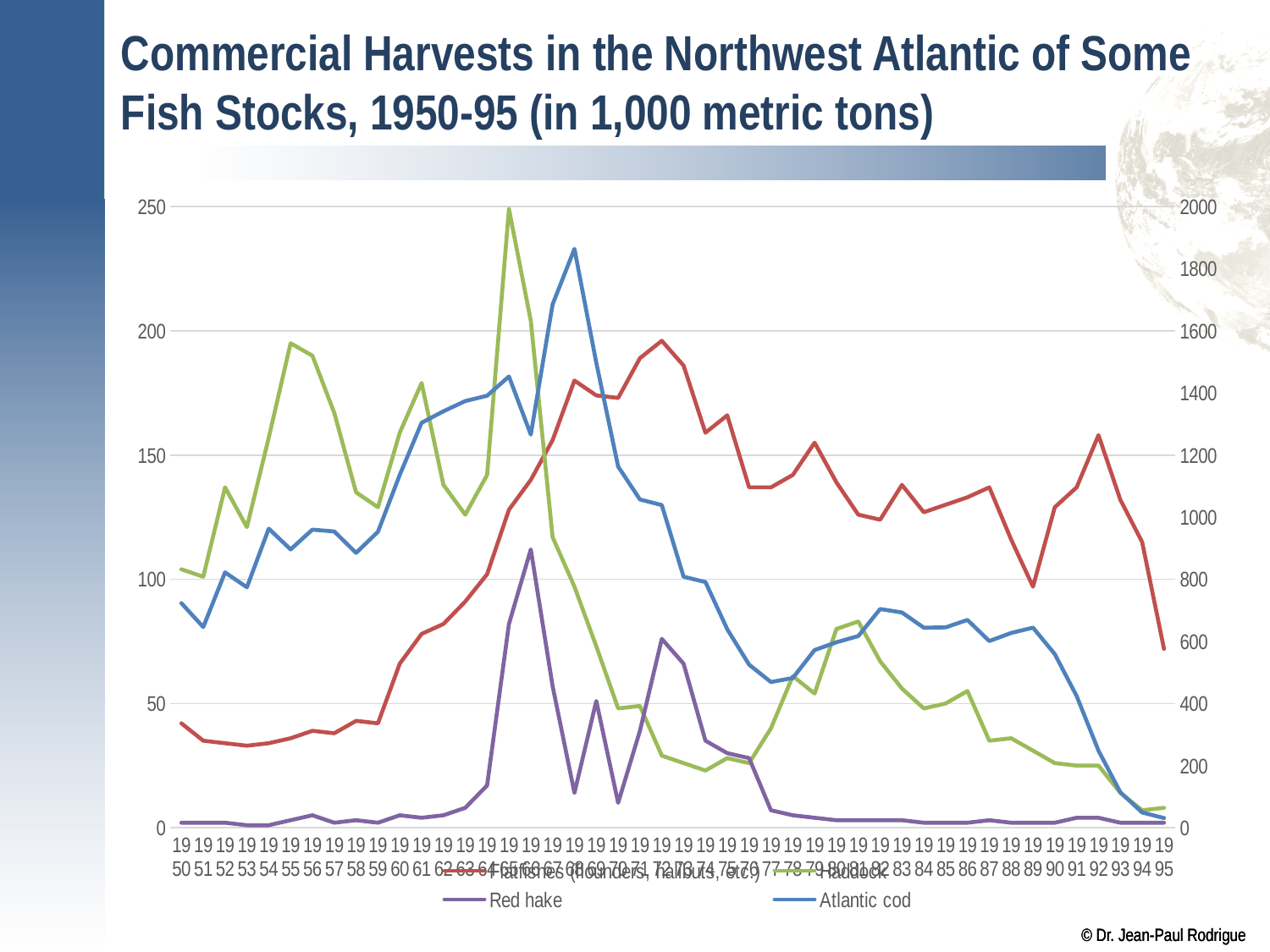
In which year does the Flatfishes (flounders, halibuts, etc.) line reach its highest point? 1972 In which year does the Red hake line reach its highest point? 1966 What colour is the Atlantic cod line? Blue In which year does the Atlantic cod line reach its highest point? 1968 What kind of chart is shown on the slide? Line chart Does the Flatfishes (flounders, halibuts, etc.) line rise or fall overall from 1950 to 1972? Rise What is the title of the chart? Commercial Harvests in the Northwest Atlantic of Some Fish Stocks, 1950-95 (in 1,000 metric tons) How many series does the legend list? 4 Is the Flatfishes (flounders, halibuts, etc.) value larger in 1972 or in 1995? 1972 Does the Atlantic cod line rise or fall overall from 1968 to 1995? Fall How many years are plotted along the x axis? 46